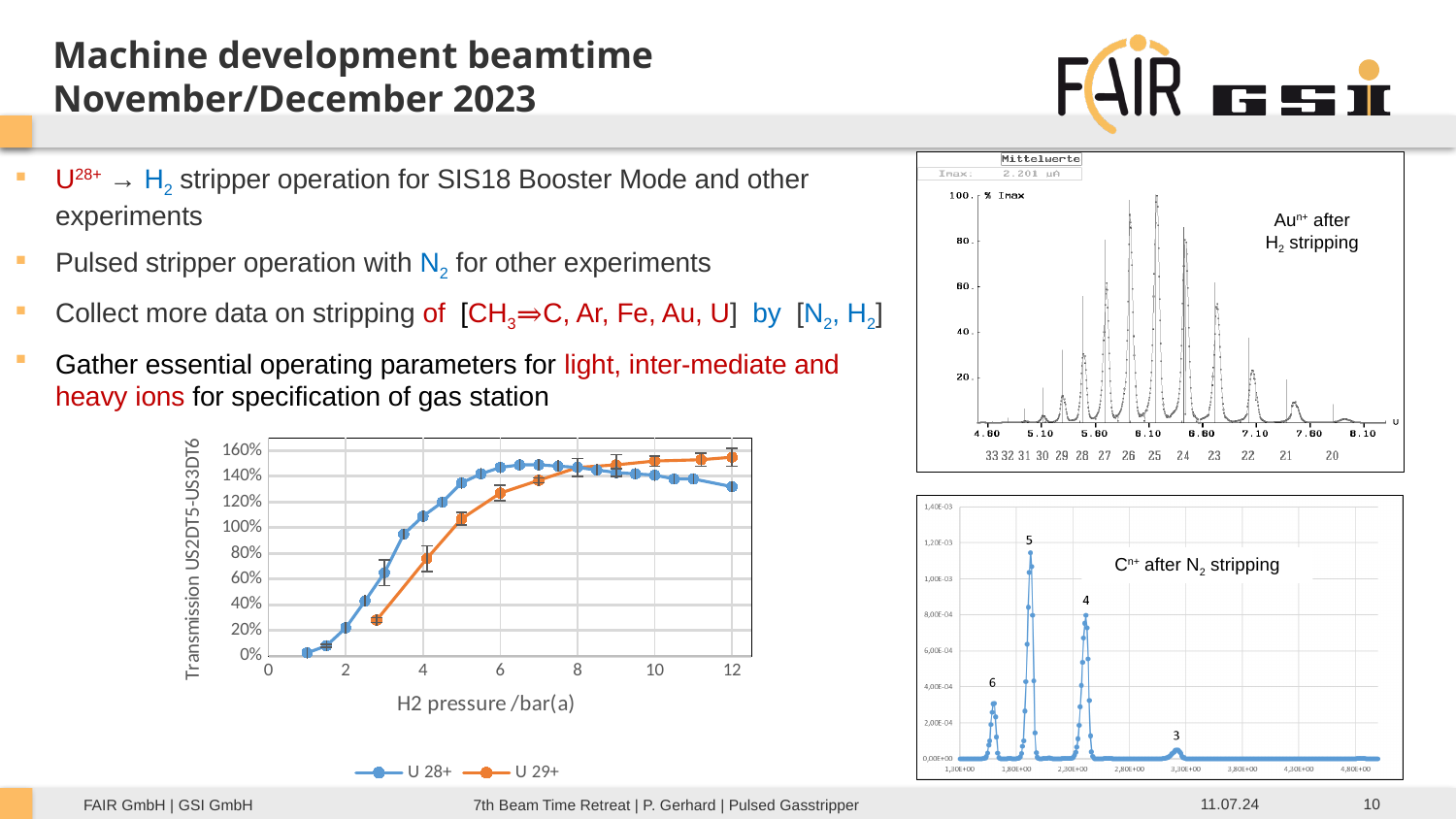
In the 'C n+ after N2 stripping' chart at the bottom right, which labelled charge state has the highest peak? 5 In the transmission versus H2 pressure chart, which series has the higher transmission at 12 bar(a), U 28+ or U 29+? U 29+ What kind of chart is the transmission versus H2 pressure chart at the bottom left of the slide? line chart In the 'C n+ after N2 stripping' chart at the bottom right, is the peak labelled 5 greater or less than 1,00E-03? greater How many series does the legend of the transmission versus H2 pressure chart list? 2 In the transmission versus H2 pressure chart, which two series are listed in the legend? U 28+ and U 29+ In the transmission versus H2 pressure chart, is the U 29+ transmission at 12 bar(a) greater or less than 140%? greater In the transmission versus H2 pressure chart, does the U 29+ transmission rise or fall as H2 pressure increases from 2 to 12 bar(a)? rise In the transmission versus H2 pressure chart, is the U 28+ transmission at 12 bar(a) greater or less than 140%? less What is the x-axis title of the transmission chart at the bottom left of the slide? H2 pressure /bar(a) In the transmission versus H2 pressure chart, which series has the higher transmission at 4 bar(a), U 28+ or U 29+? U 28+